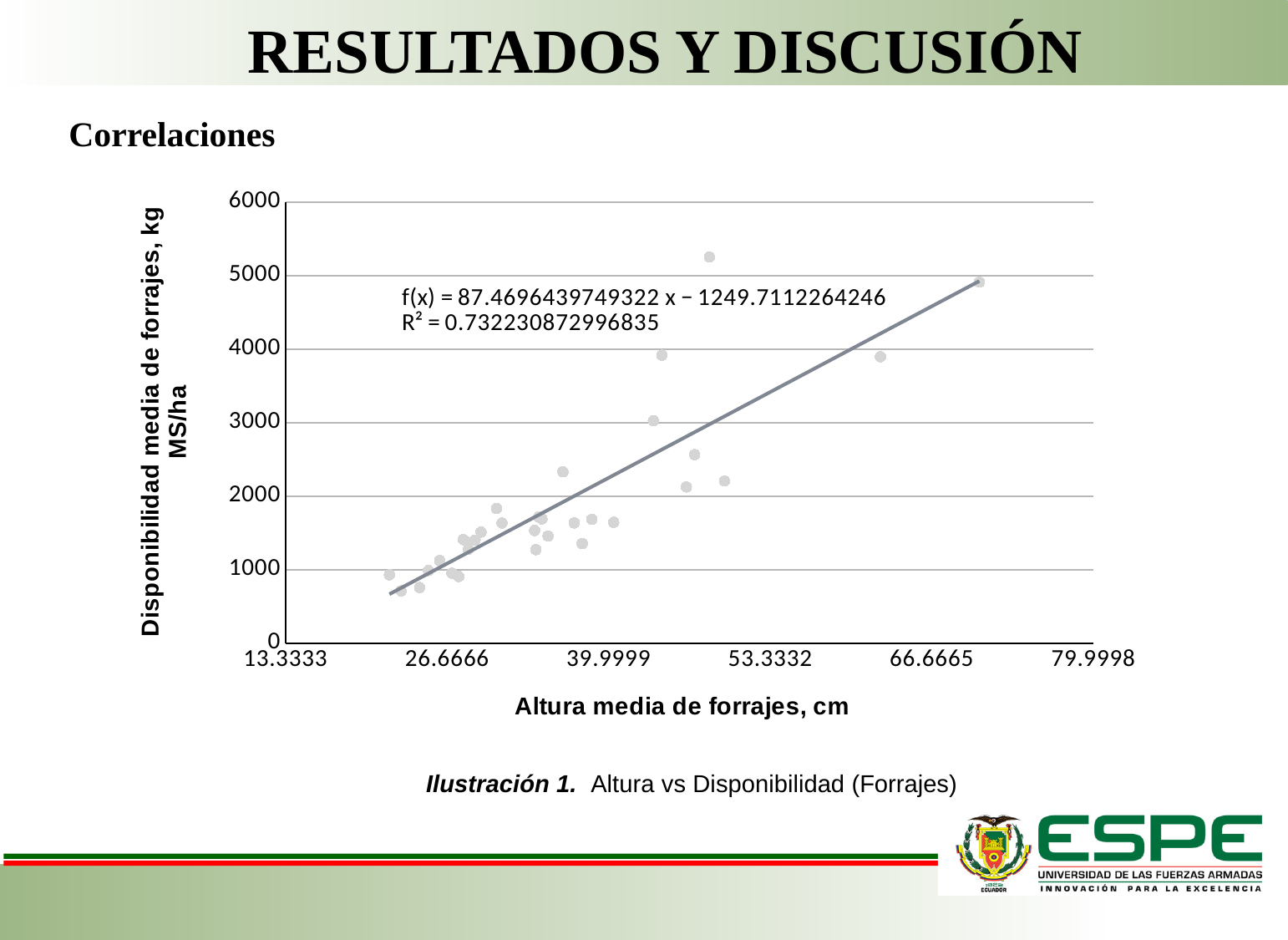
What is the title of the x axis? Altura media de forrajes, cm What kind of chart is shown on the slide? Scatter chart What is the slope of the fitted line f(x) printed on the chart? 87.4696439749322 What is the maximum value shown on the y axis? 6000 What is the first tick label shown on the x axis? 13.3333 As the height of forage (x axis) increases, do the availability values generally rise or fall? Rise Is the lowest plotted point greater or less than 1000 kg MS/ha? less Is the highest plotted point greater or less than 5000 kg MS/ha? greater What is the intercept of the fitted line f(x) printed on the chart? −1249.7112264246 What is the caption given below the chart? Ilustración 1. Altura vs Disponibilidad (Forrajes) What is the R² value printed on the chart? 0.732230872996835